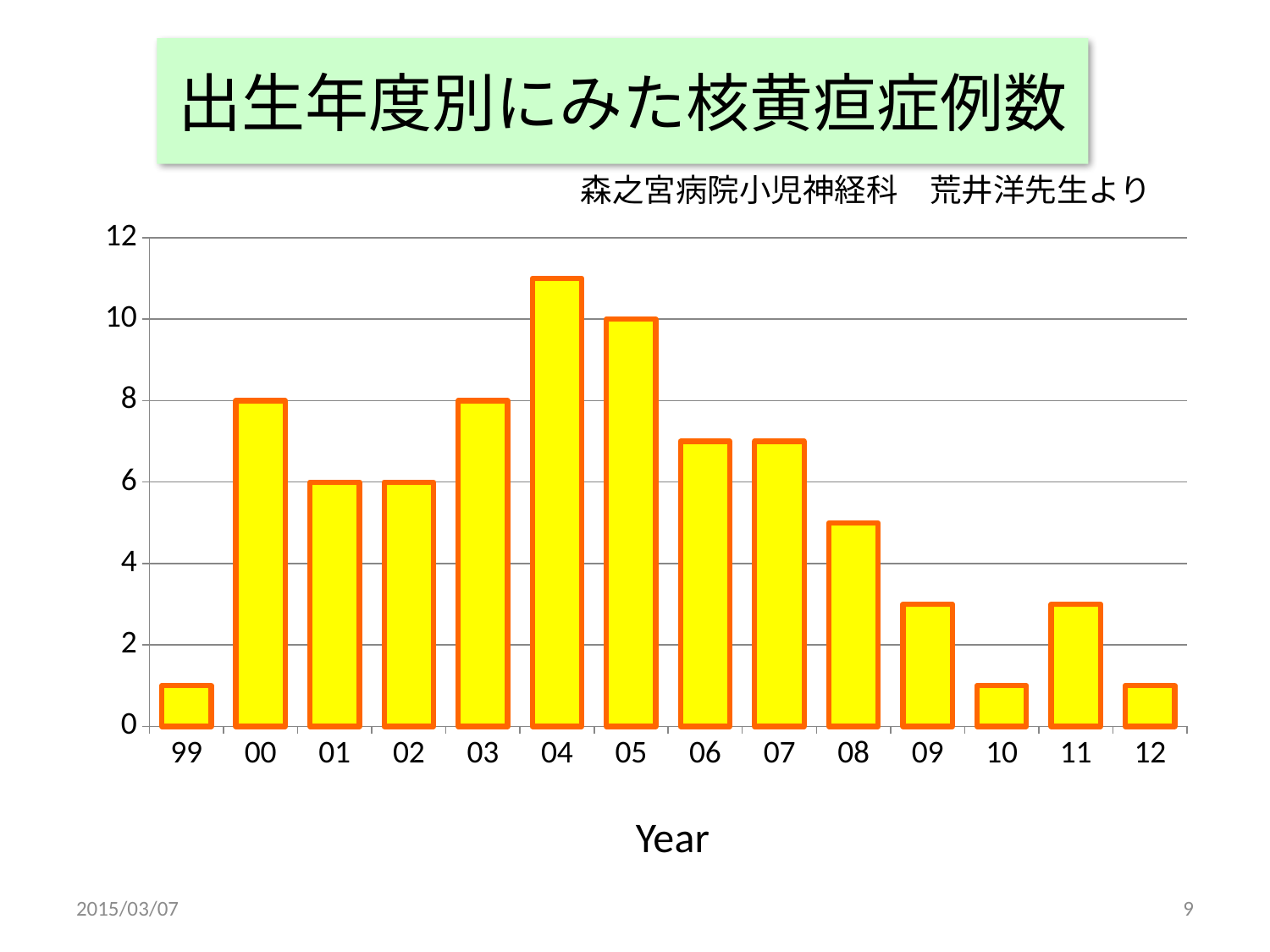
Is the value for year 09 greater or less than 4? less Which is larger, the value for year 05 or the value for year 03? 05 What kind of chart is shown on the slide? bar chart What is the label of the x axis? Year What is the value for year 01? 6 What is the difference between the values for year 05 and year 00? 2 Do the values rise or fall from year 05 to year 10? fall Is the value for year 04 greater or less than 10? greater Which year has the highest number of cases? 04 How many years (categories) are plotted on the x axis? 14 What is the value for year 05? 10 What is the value for year 00? 8